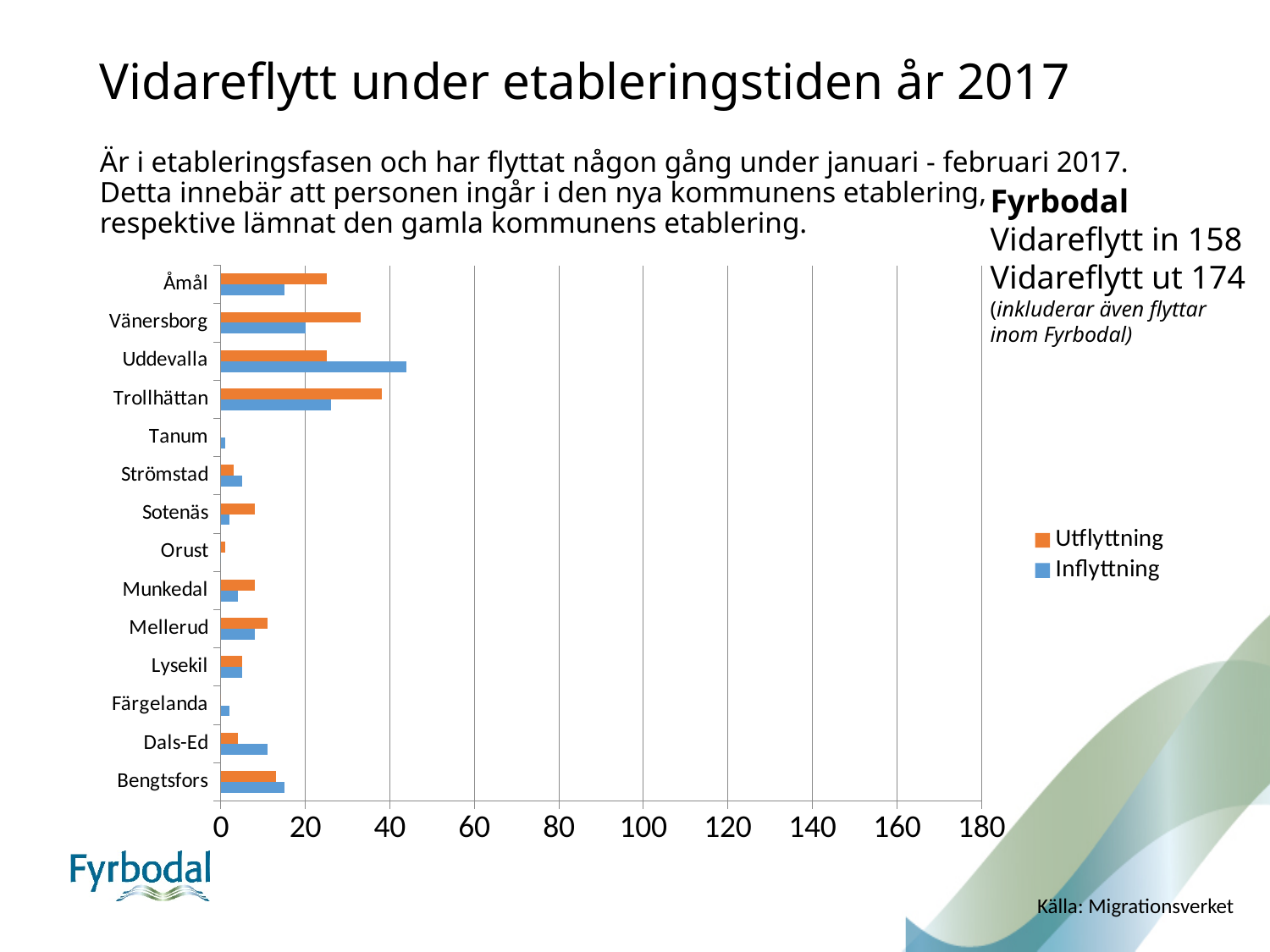
Which colour represents Utflyttning in the legend? orange Which municipality has the highest Inflyttning value? Uddevalla Is the Utflyttning value for Åmål greater or less than 20? greater Which municipality has the highest Utflyttning value? Trollhättan What kind of chart is shown on the slide? bar chart How many municipalities (categories) are shown on the chart? 14 For Trollhättan, which is larger: Utflyttning or Inflyttning? Utflyttning Is the Inflyttning value for Uddevalla greater or less than 40? greater For Dals-Ed, which is larger: Utflyttning or Inflyttning? Inflyttning Is the Utflyttning value for Vänersborg greater or less than 40? less How many series does the legend list? 2 For Uddevalla, which is larger: Utflyttning or Inflyttning? Inflyttning